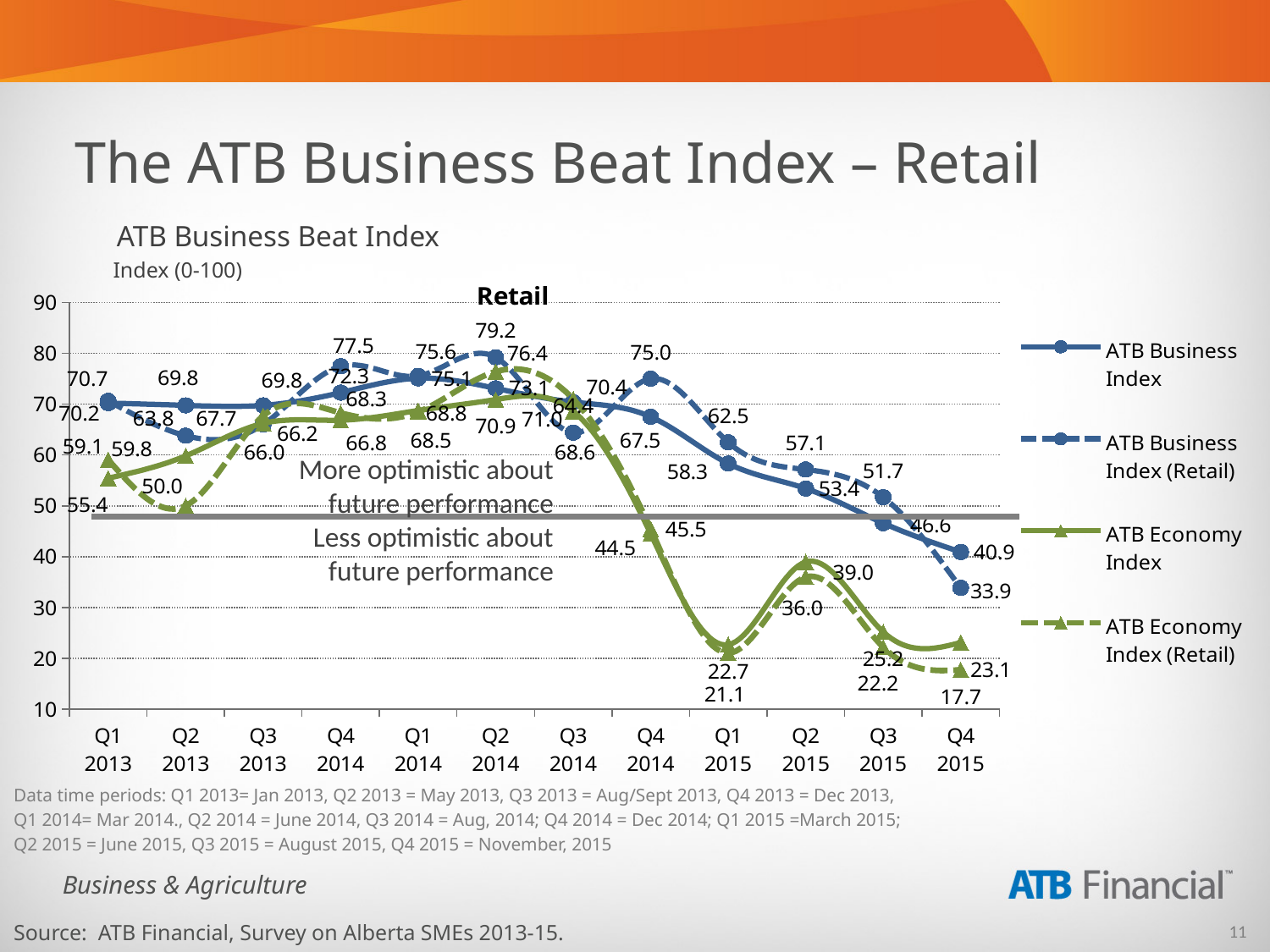
What is the value of the ATB Economy Index (Retail) in Q4 2015? 17.7 What is the difference between the ATB Business Index (40.9) and the ATB Business Index (Retail) (33.9) in Q4 2015? 7.0 How many quarters are plotted along the x axis? 12 Does the ATB Business Index (Retail) rise or fall between Q4 2014 and Q4 2015? Fall In which quarter does the ATB Economy Index (Retail) reach its lowest value? Q4 2015 What is the title of the chart? Retail Is the value of the ATB Economy Index (Retail) in Q1 2015 greater or less than 30? less What is the value of the ATB Business Index (Retail) in Q4 2015? 33.9 What is the highest value reached by the ATB Business Index (Retail), and in which quarter? 79.2 in Q2 2014 What kind of chart is shown on the slide? Line chart In Q1 2015, which is larger: the ATB Business Index (Retail) or the ATB Economy Index (Retail)? ATB Business Index (Retail) How many series does the legend list? 4